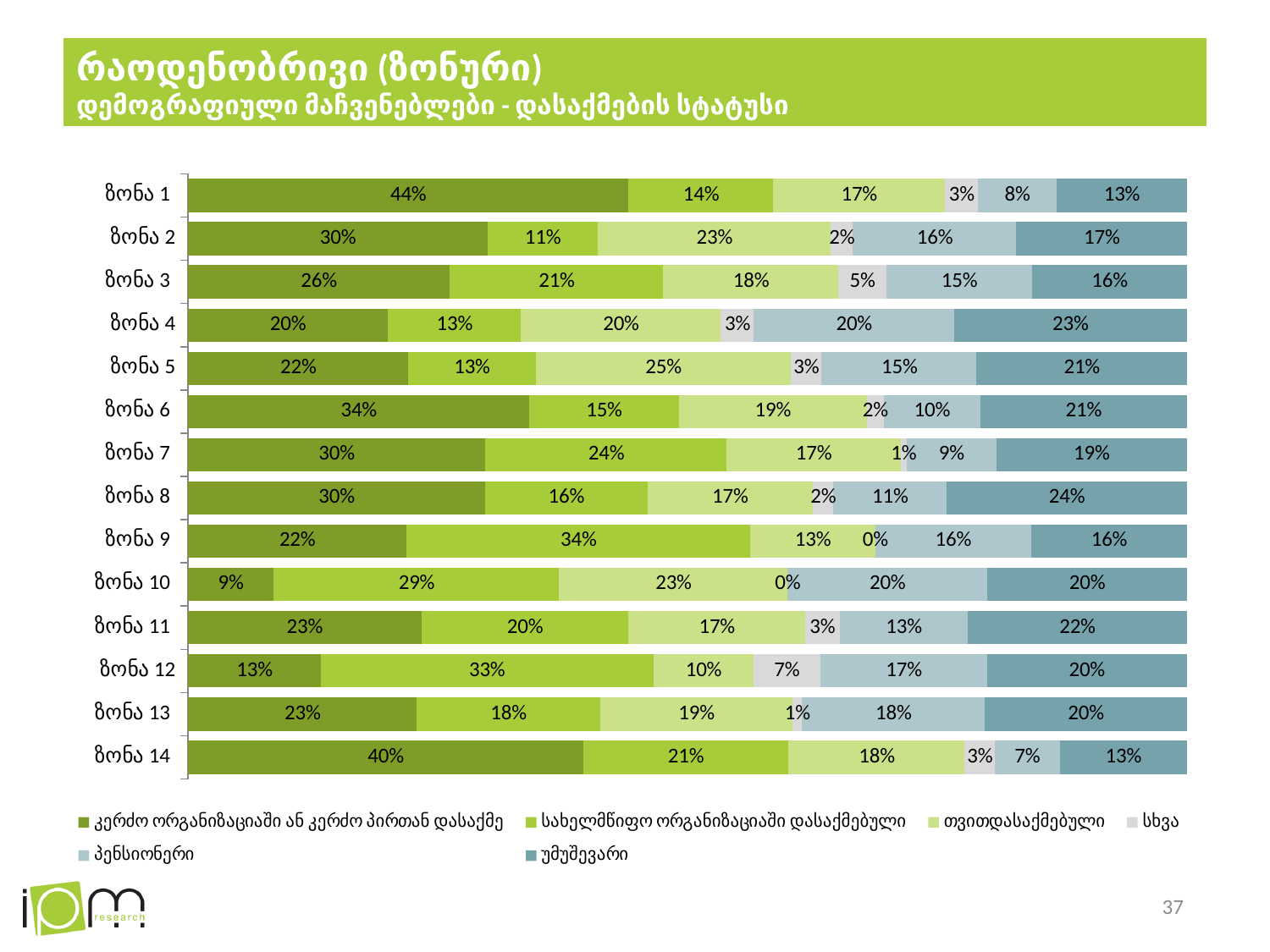
What kind of chart is shown on the slide? stacked bar chart Which zone has the highest value for the კერძო ორგანიზაციაში ან კერძო პირთან დასაქმე segment? ზონა 1 How many zones (categories) are shown in the chart? 14 Which zone has the lowest value for the კერძო ორგანიზაციაში ან კერძო პირთან დასაქმე segment? ზონა 10 What is the value of the სხვა segment for ზონა 3? 5% What is the value of the პენსიონერი segment for ზონა 10? 20% How many series does the legend list? 6 What is the value of the სახელმწიფო ორგანიზაციაში დასაქმებული segment for ზონა 12? 33% What is the difference between the კერძო ორგანიზაციაში ან კერძო პირთან დასაქმე values for ზონა 1 and ზონა 14? 4% What is the value of the უმუშევარი segment for ზონა 8? 24% Which is larger: the სახელმწიფო ორგანიზაციაში დასაქმებული value for ზონა 9 or for ზონა 7? ზონა 9 What is the value of the first (darkest green) segment, კერძო ორგანიზაციაში ან კერძო პირთან დასაქმე, for ზონა 1? 44%